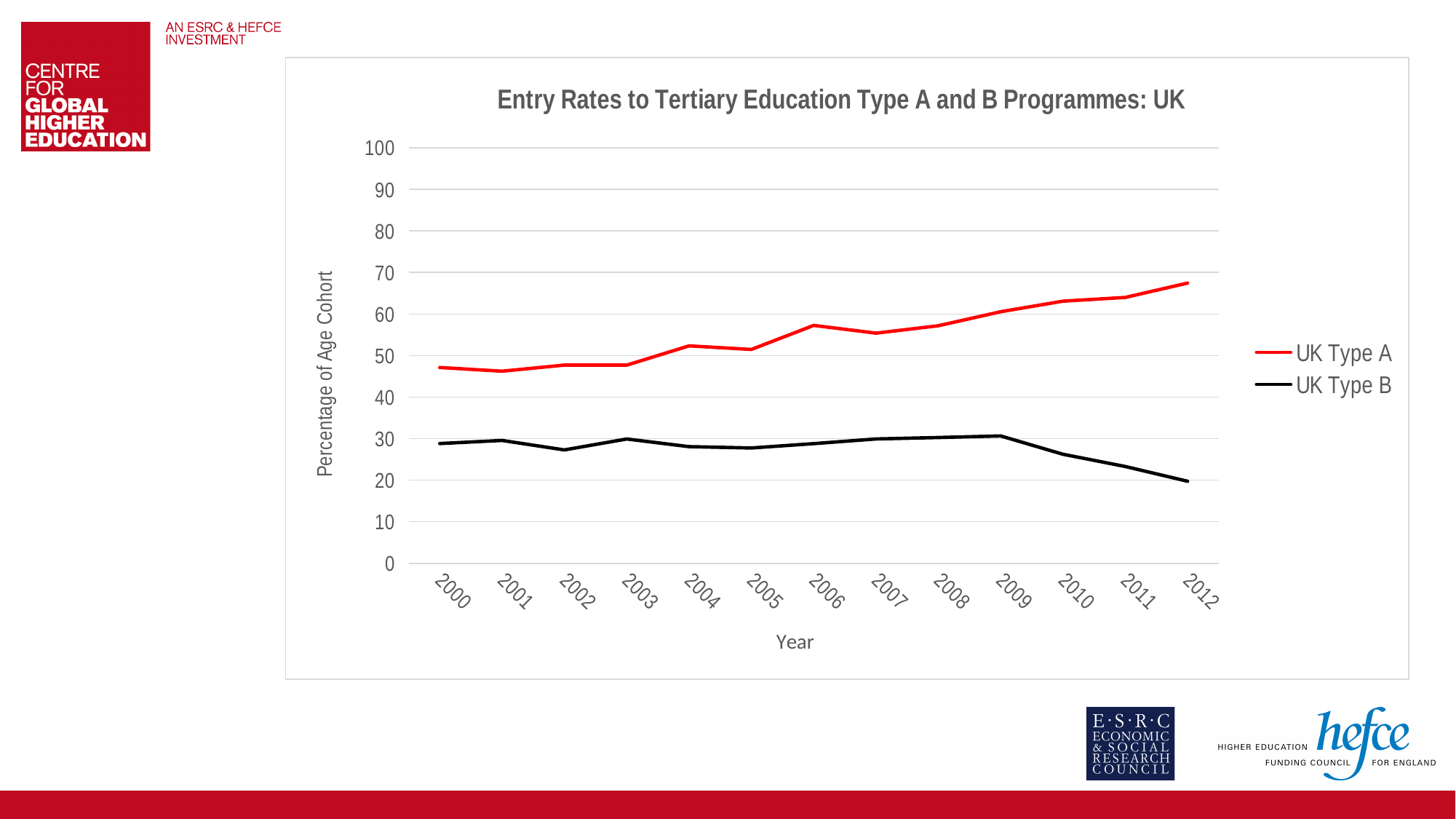
In which year does the UK Type B series reach its lowest value? 2012 How many years are plotted along the x axis? 13 How many series does the legend list? 2 Is the value for UK Type A in 2000 greater or less than 50? less Which series has the larger value in 2008, UK Type A or UK Type B? UK Type A What is the title of the chart? Entry Rates to Tertiary Education Type A and B Programmes: UK Is the value for UK Type A in 2012 greater or less than 60? greater What kind of chart is shown on the slide? line chart Does the UK Type A line generally rise or fall from 2000 to 2012? rise Is the value for UK Type B in 2010 greater or less than 30? less What is the label of the vertical axis? Percentage of Age Cohort In which year does the UK Type A series reach its highest value? 2012